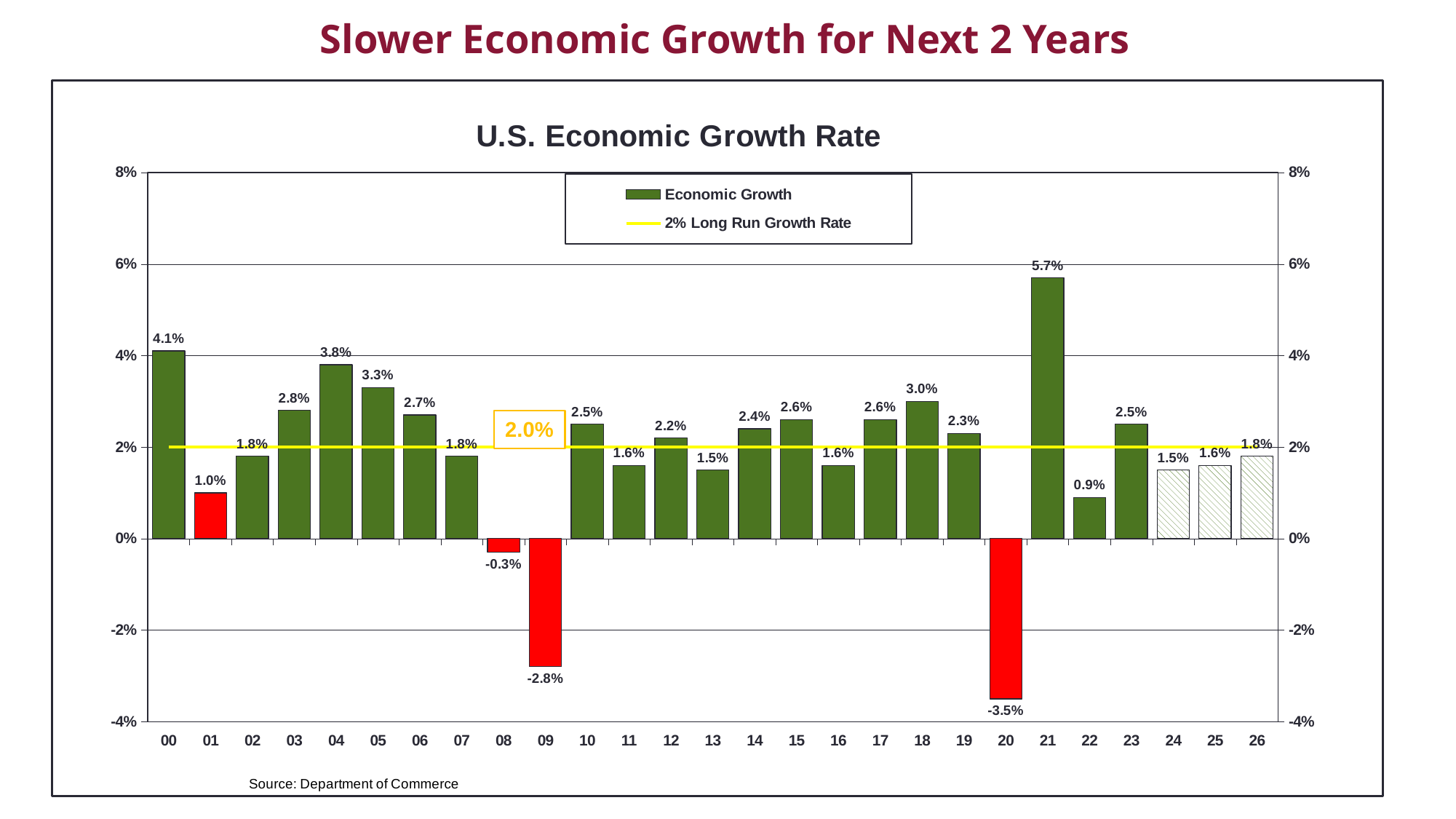
What is the economic growth rate shown for 09? -2.8% What value does the yellow horizontal line represent? 2.0% How many entries does the legend list? 2 Which year has the highest economic growth rate? 21 What is the economic growth rate shown for 21? 5.7% What kind of chart is this? bar chart How many years are shown on the x axis? 27 Which year has a higher growth rate, 04 or 05? 04 Which year has the lowest economic growth rate? 20 What is the title of the chart? U.S. Economic Growth Rate What is the difference between the growth rate in 00 and the growth rate in 01? 3.1% What is the economic growth rate shown for 26? 1.8%